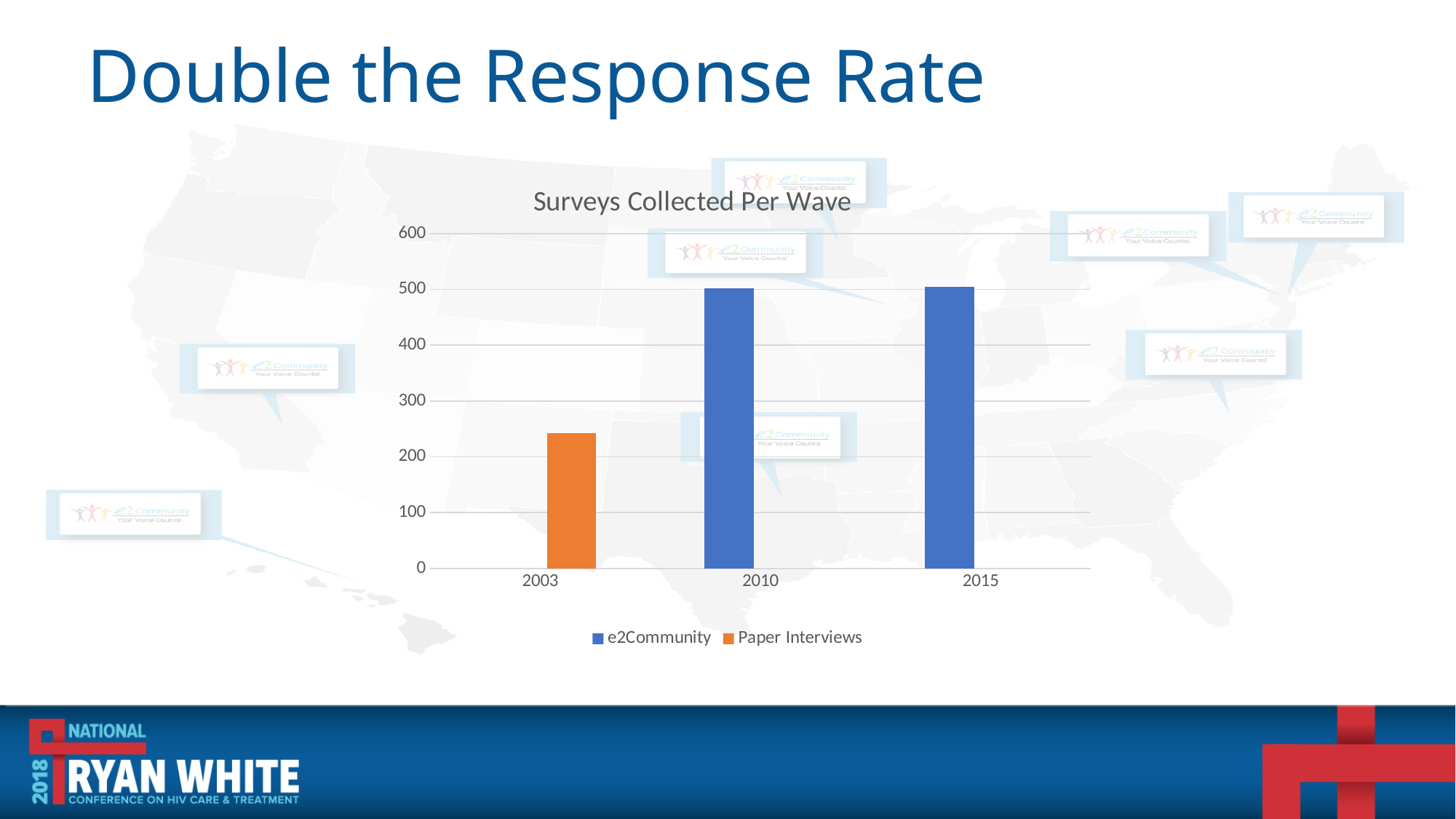
How many years are shown on the x axis of the chart? 3 Do the values rise or fall from 2003 to 2010? rise Is the value for 2010 greater or less than 400? greater Which is larger, the value for 2003 or the value for 2010? 2010 Which year has the lowest number of surveys collected? 2003 Is the value for 2015 greater or less than 400? greater Is the value for 2003 greater or less than 200? greater What kind of chart is shown on the slide? bar chart How many series does the chart legend list? 2 Which series is shown in orange in the chart legend? Paper Interviews What is the title of the chart? Surveys Collected Per Wave